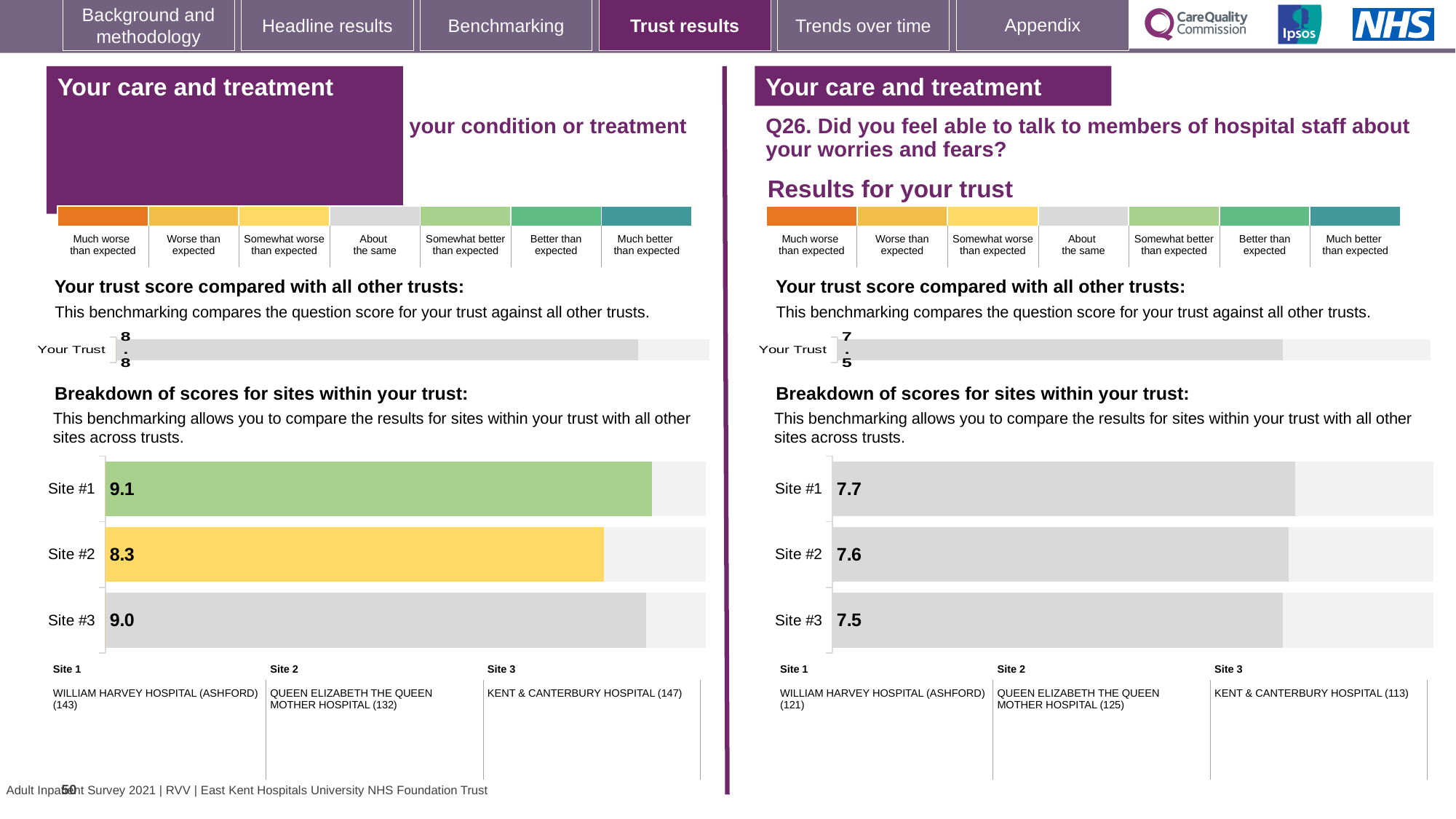
On the right-hand chart (Q26), which is larger: the score for Site #1 or Site #3? Site #1 On the left-hand site breakdown chart, which site has the highest score? Site #1 On the right-hand (Q26) 'Your trust score compared with all other trusts' chart, what is the value for Your Trust? 7.5 On the left-hand site breakdown chart, which site has the lowest score? Site #2 On the right-hand chart (Q26), which site has the lowest score? Site #3 On the right-hand chart (Q26), what is the score for Site #1? 7.7 On the left-hand site breakdown chart, what is the score for Site #2? 8.3 What type of chart is used for the site breakdown on the right-hand side (Q26)? Bar chart On the left-hand 'Your trust score compared with all other trusts' chart, what is the value for Your Trust? 8.8 On the left-hand site breakdown chart, what is the difference between the scores for Site #1 and Site #2? 0.8 How many sites are shown in the left-hand site breakdown chart? 3 On the right-hand chart (Q26), what is the difference between the scores for Site #1 and Site #3? 0.2